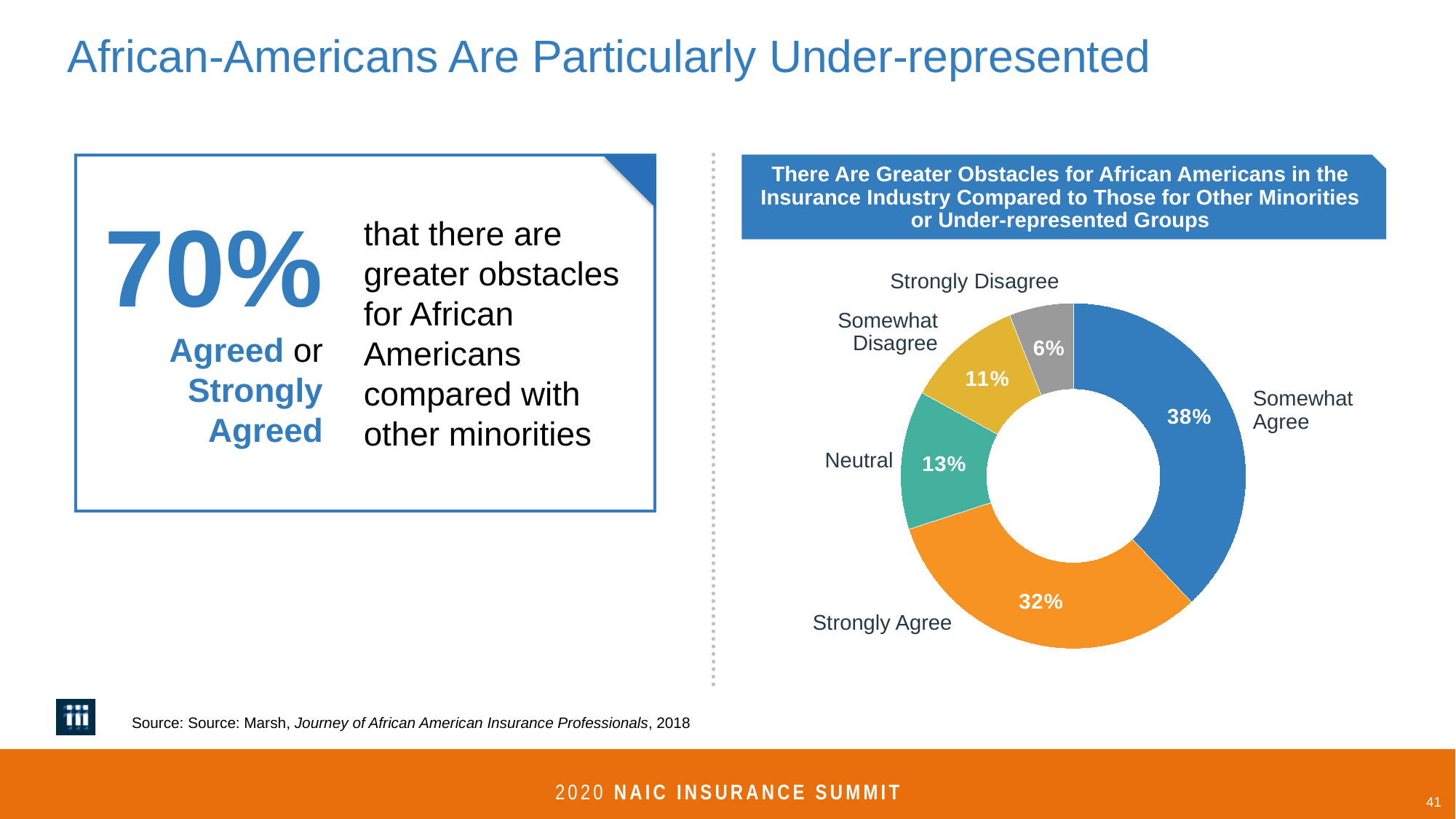
What percentage of respondents answered Somewhat Disagree? 11% What is the difference in percentage points between Somewhat Agree and Strongly Agree? 6 What is the combined share of Somewhat Agree and Strongly Agree? 70% What percentage of respondents answered Neutral? 13% What kind of chart is shown on the slide? Doughnut (pie) chart What percentage of respondents answered Strongly Disagree? 6% What percentage of respondents answered Strongly Agree? 32% How many response categories are shown in the chart? 5 Which response category has the largest share of the chart? Somewhat Agree Which is larger, the share for Neutral or the share for Somewhat Disagree? Neutral Which response category has the smallest share of the chart? Strongly Disagree What percentage of respondents answered Somewhat Agree? 38%